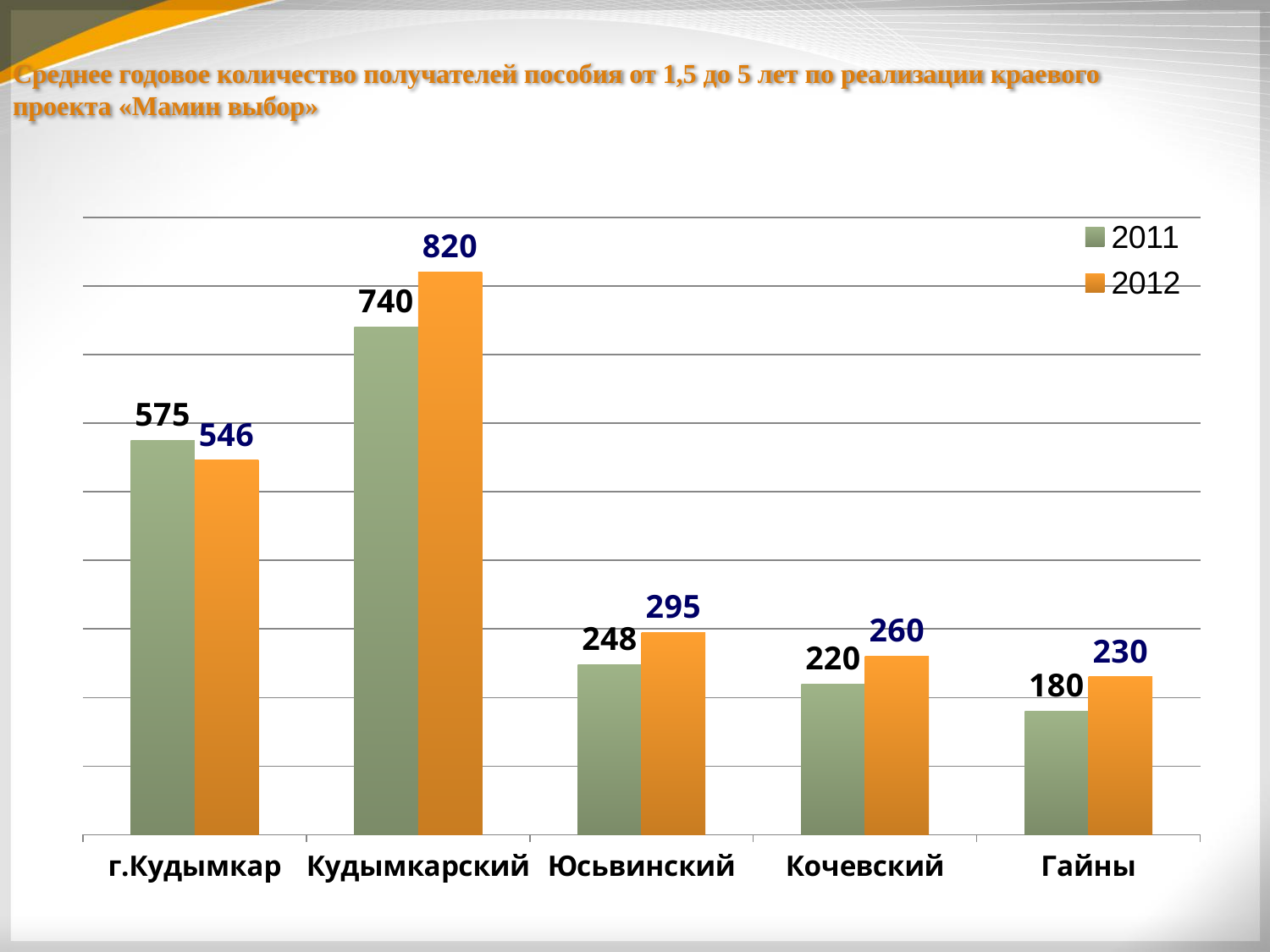
How many series does the legend list? 2 What is the difference between the 2011 and 2012 values for г.Кудымкар? 29 Which category has the lowest 2011 value? Гайны Which is larger for Кочевский, the 2011 value or the 2012 value? 2012 How many categories are shown on the x axis? 5 What is the 2011 value for г.Кудымкар? 575 What is the 2012 value for Гайны? 230 What kind of chart is shown on the slide? Bar chart Which category has the highest 2012 value? Кудымкарский What is the 2011 value for Юсьвинский? 248 What is the 2012 value for Кудымкарский? 820 What is the difference between the 2012 and 2011 values for Кудымкарский? 80